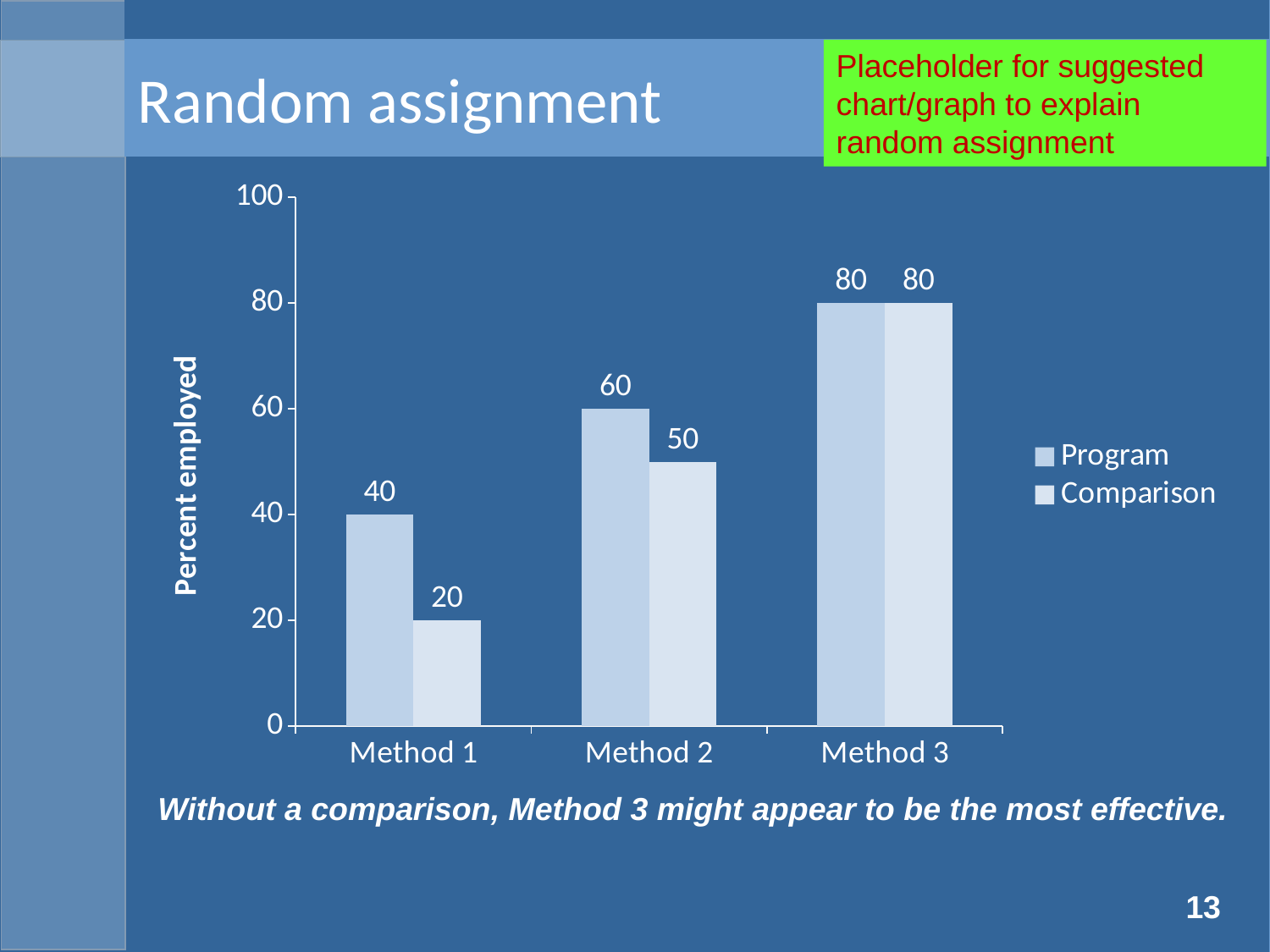
Which method has the highest Program value? Method 3 Which is larger for Method 2, the Program value or the Comparison value? Program Which method has the lowest Comparison value? Method 1 What is the label of the y axis? Percent employed What is the Comparison value for Method 2? 50 How many series does the legend list? 2 What kind of chart is shown on the slide? Bar chart What is the difference between the Program and Comparison values for Method 3? 0 What is the difference between the Program and Comparison values for Method 1? 20 What is the Program value for Method 1? 40 What is the Program value for Method 3? 80 How many methods are shown on the x axis? 3